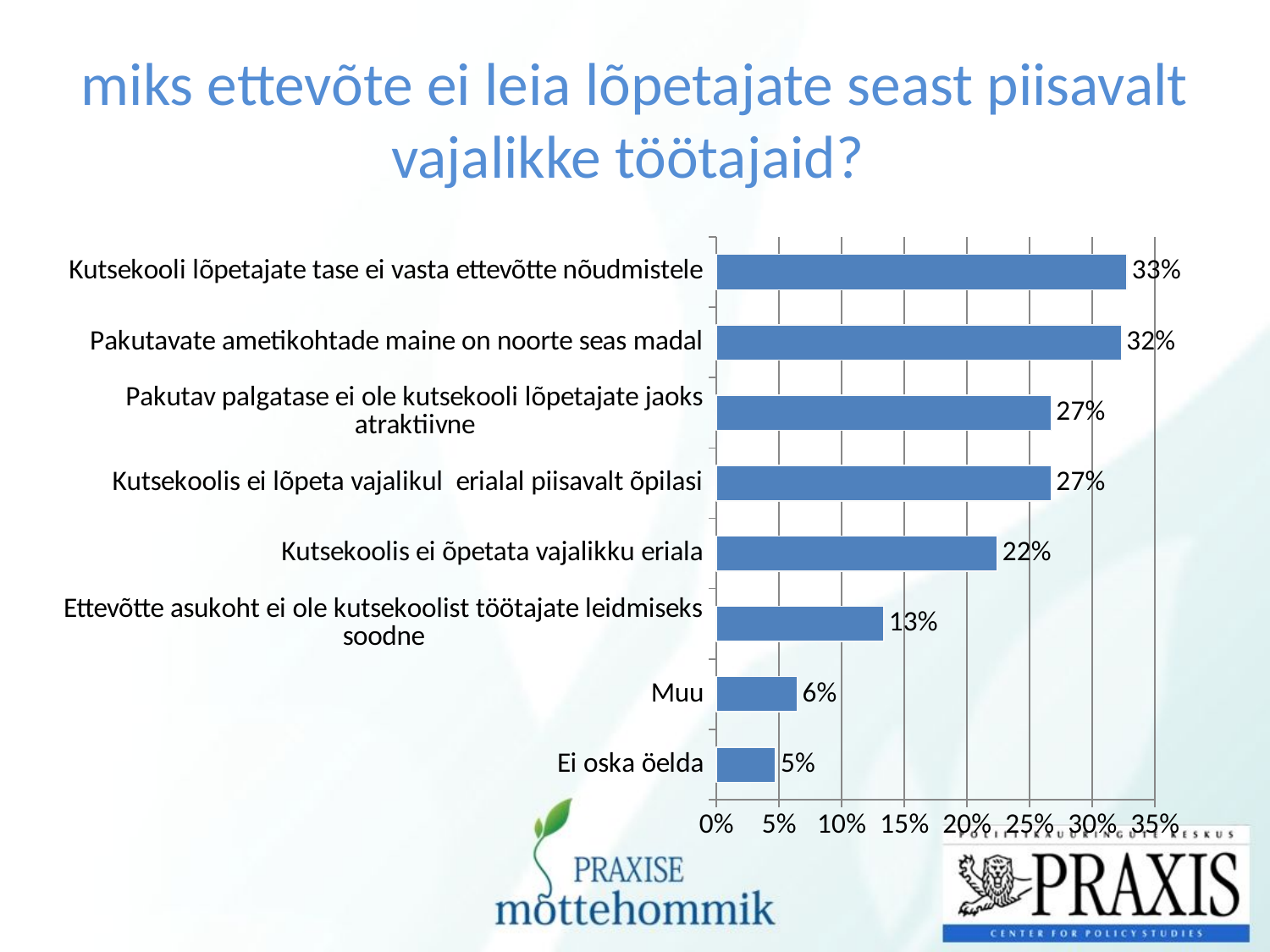
What is the value for "Kutsekoolis ei õpetata vajalikku eriala"? 22% How many categories are shown in the chart? 8 What is the maximum value shown on the horizontal axis? 35% What is the value for "Kutsekooli lõpetajate tase ei vasta ettevõtte nõudmistele"? 33% What is the value for "Muu"? 6% What is the difference between the values for "Kutsekoolis ei õpetata vajalikku eriala" and "Ettevõtte asukoht ei ole kutsekoolist töötajate leidmiseks soodne"? 9% What is the value for "Pakutavate ametikohtade maine on noorte seas madal"? 32% Which category has the lowest value? Ei oska öelda What is the value for "Ettevõtte asukoht ei ole kutsekoolist töötajate leidmiseks soodne"? 13% Which category has the highest value? Kutsekooli lõpetajate tase ei vasta ettevõtte nõudmistele Which is larger: the value for "Pakutav palgatase ei ole kutsekooli lõpetajate jaoks atraktiivne" or the value for "Kutsekoolis ei õpetata vajalikku eriala"? Pakutav palgatase ei ole kutsekooli lõpetajate jaoks atraktiivne What kind of chart is shown on the slide? Bar chart